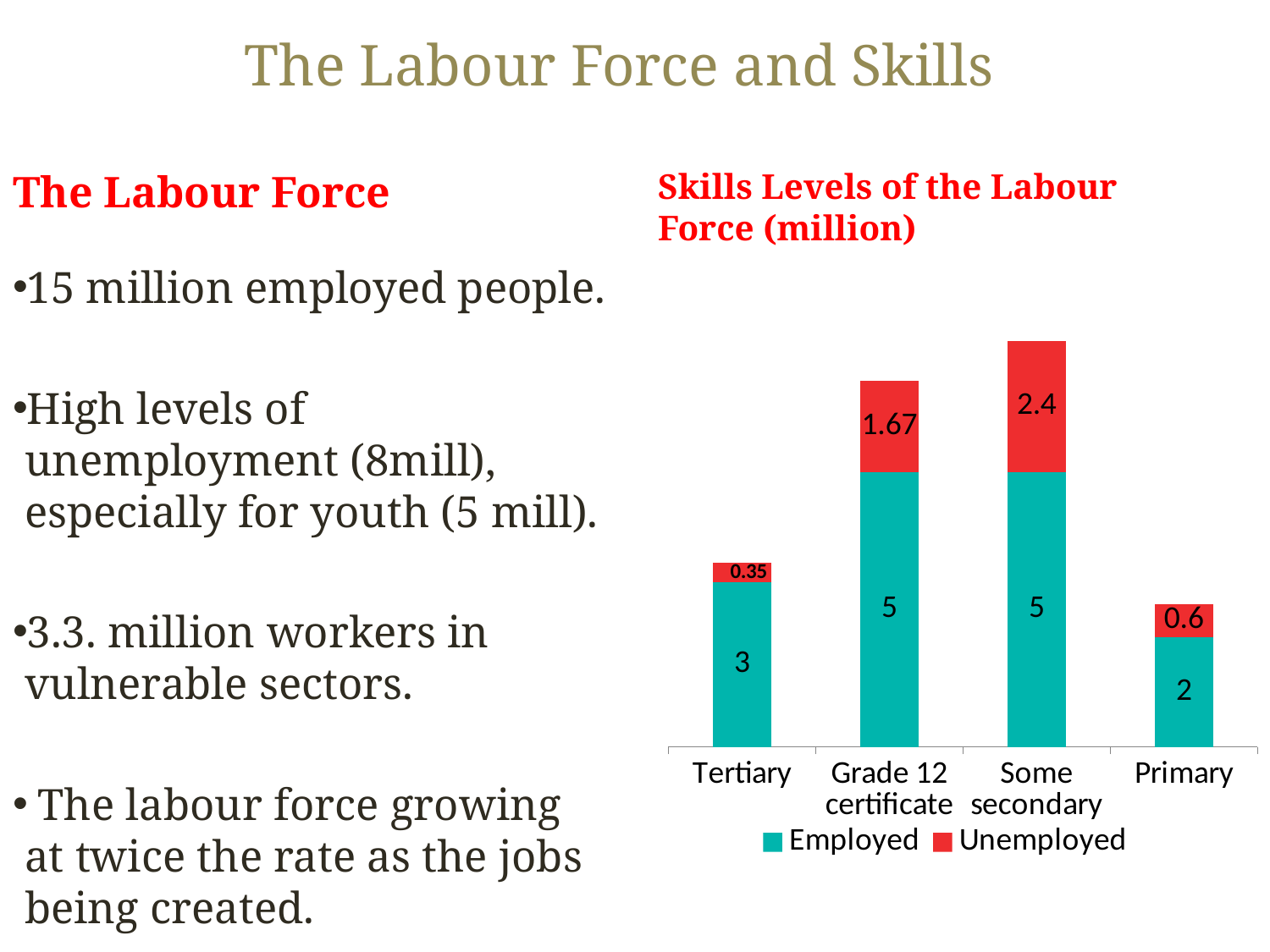
Which category has the lowest Unemployed value? Tertiary What is the difference between the Unemployed values for Some secondary and Grade 12 certificate? 0.73 How many series does the legend list? 2 What is the Unemployed value for Grade 12 certificate? 1.67 What is the total of the stacked bar for Some secondary? 7.4 How many categories are shown on the x axis? 4 Which category has the highest Unemployed value? Some secondary Is the Employed value for Grade 12 certificate larger or smaller than the Employed value for Primary? larger What is the Employed value for Primary? 2 What kind of chart is shown on the slide? Stacked bar chart What is the Unemployed value for Some secondary? 2.4 What is the Employed value for Tertiary? 3